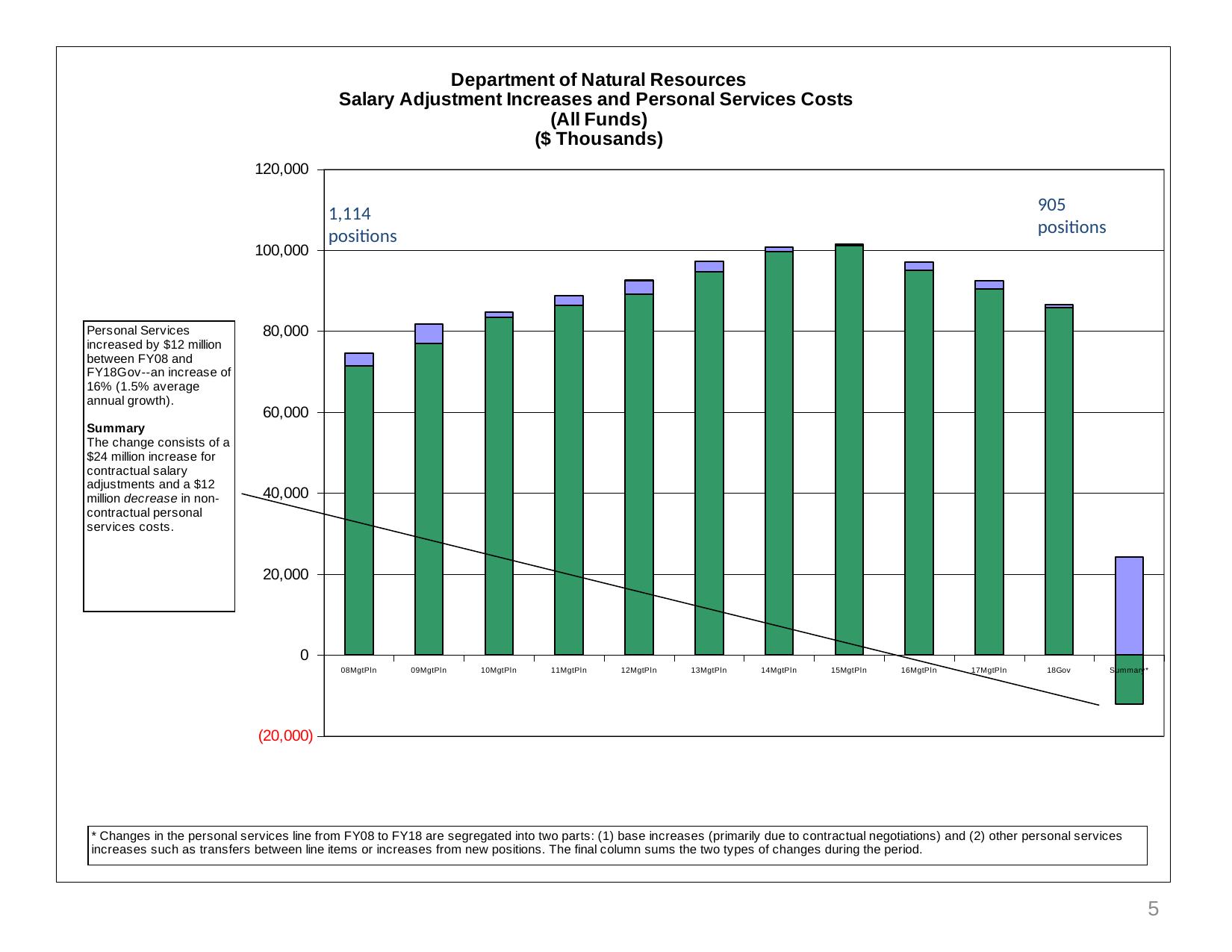
Do the bar totals rise or fall from 15MgtPln to 18Gov? fall Is the total value for 18Gov greater or less than 80,000? greater Which category has the tallest bar in the chart? 15MgtPln Which bar is taller, 13MgtPln or 11MgtPln? 13MgtPln How many categories are shown along the x axis of the chart? 12 Is the total value for 08MgtPln greater or less than 80,000? less How many positions are noted on the chart for the 18Gov end of the period? 905 positions What kind of chart is shown on the slide? Stacked bar chart Is the total value for 15MgtPln greater or less than 100,000? greater Which bar is taller, 09MgtPln or 17MgtPln? 17MgtPln Do the bar totals rise or fall from 08MgtPln to 15MgtPln? rise Among the fiscal year bars (excluding Summary**), which category has the shortest bar? 08MgtPln